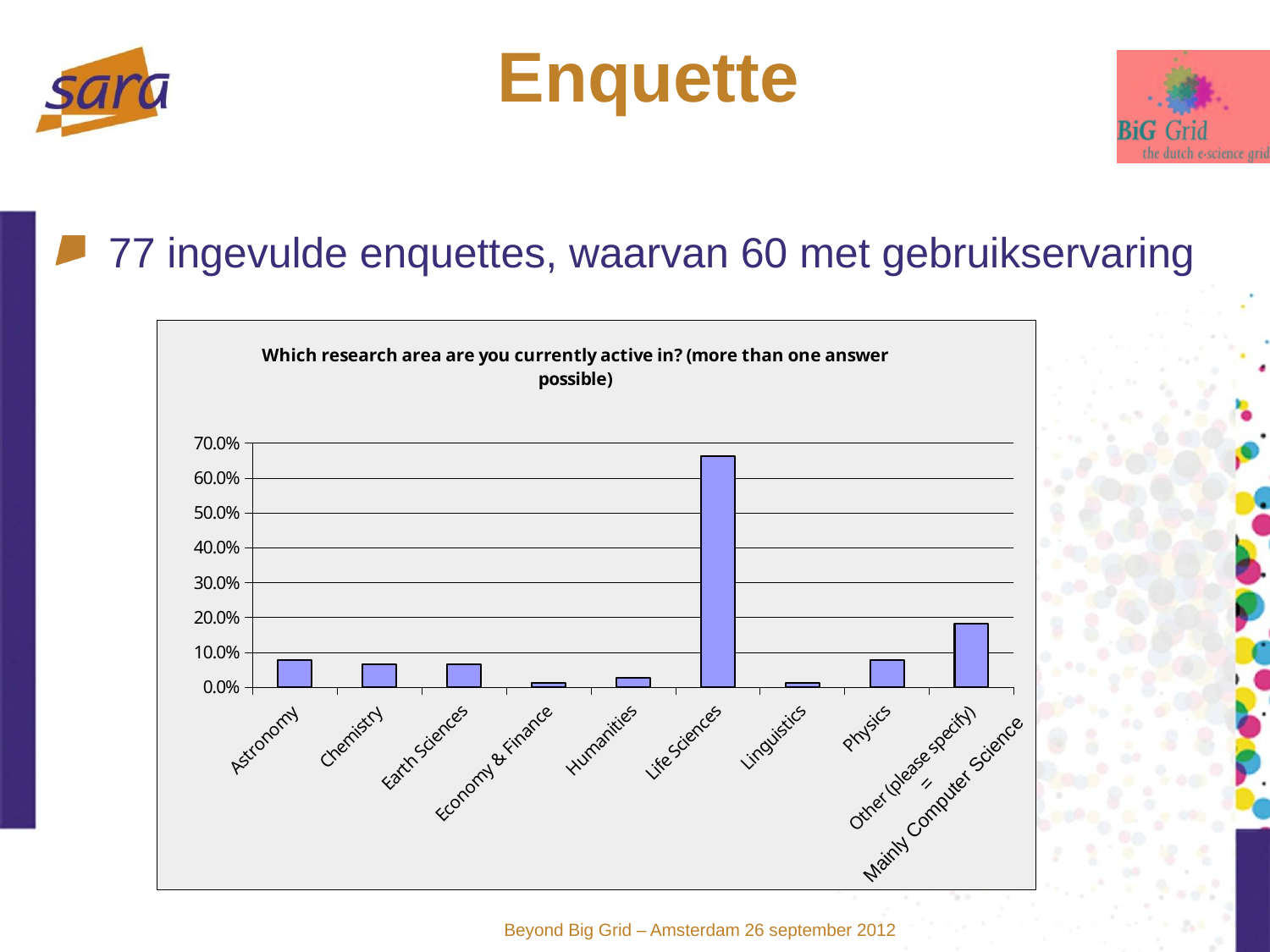
How many research area categories are shown on the x axis of the chart? 9 What kind of chart is shown on the slide? bar chart Is the value for Life Sciences greater or less than 60.0%? greater Which has the larger value, Other (please specify) = Mainly Computer Science or Chemistry? Other (please specify) = Mainly Computer Science Is the value for Humanities greater or less than 10.0%? less What is the title of the chart? Which research area are you currently active in? (more than one answer possible) Which has the larger value, Life Sciences or Physics? Life Sciences Is the value for Life Sciences greater or less than 70.0%? less Which research area has the highest bar in the chart? Life Sciences